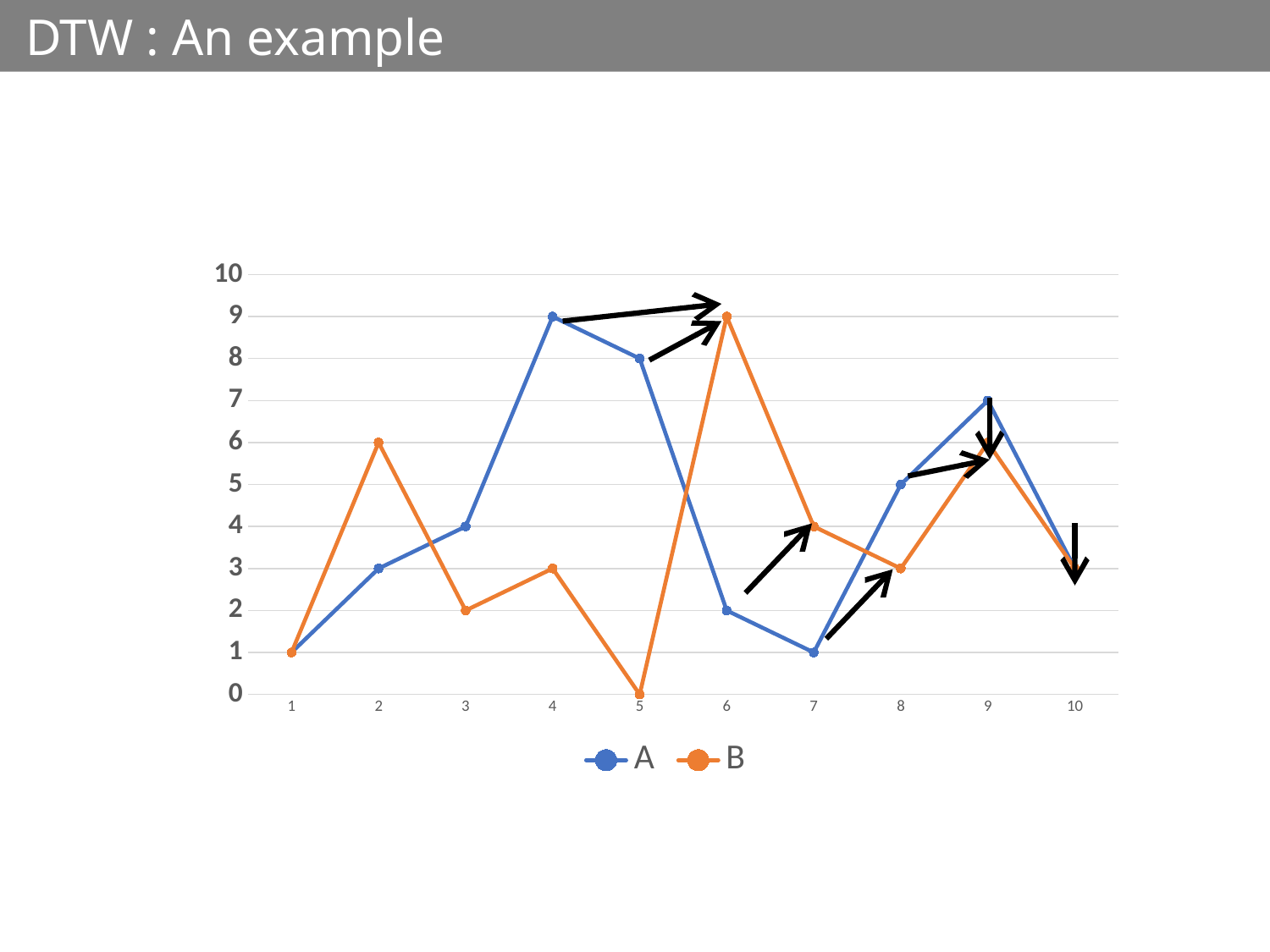
What kind of chart is shown on the slide? line chart At which x value does series A reach its highest point? 4 At x = 2, which series has the larger value, A or B? B What is the value of series B at x = 5? 0 What is the difference between series A and series B at x = 5? 8 How many points are plotted along the x axis for each series? 10 At which x value does series B reach its lowest point? 5 Does series A rise or fall from x = 6 to x = 7? fall How many series does the legend list? 2 What is the value of series B at x = 6? 9 What is the title of the slide containing the chart? DTW : An example What is the value of series A at x = 4? 9